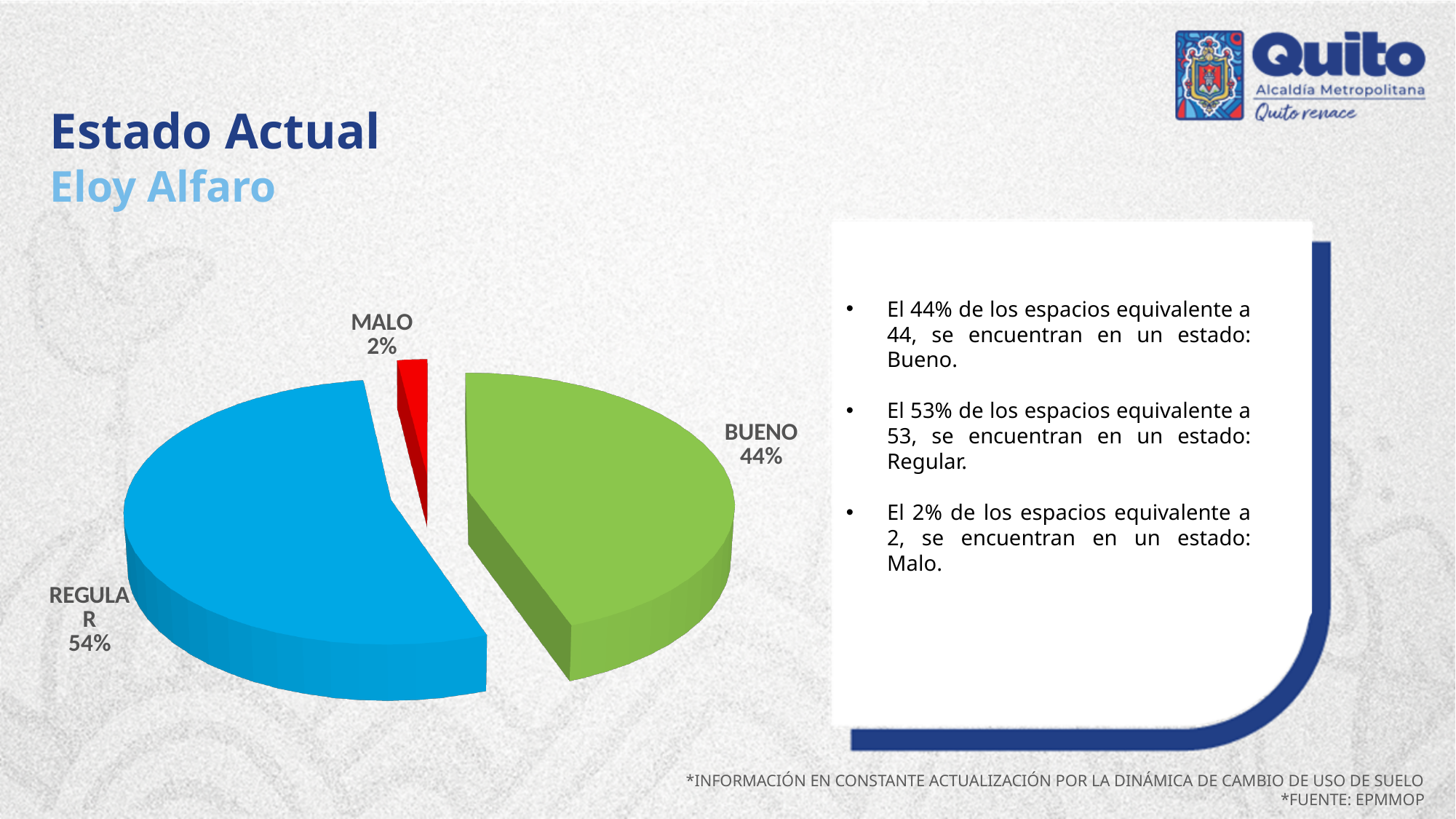
What is the difference in percentage points between REGULAR and BUENO in the pie chart? 10 What kind of chart is shown on the slide? pie chart How many slices does the pie chart have? 3 What percentage does the pie chart show for BUENO? 44% What is the difference in percentage points between BUENO and MALO in the pie chart? 42 What colour is the BUENO slice in the pie chart? green Which category has the smallest slice in the pie chart? MALO What percentage does the pie chart show for REGULAR? 54% What percentage does the pie chart show for MALO? 2% What colour is the MALO slice in the pie chart? red Which is larger in the pie chart, BUENO or REGULAR? REGULAR Which category has the largest slice in the pie chart? REGULAR